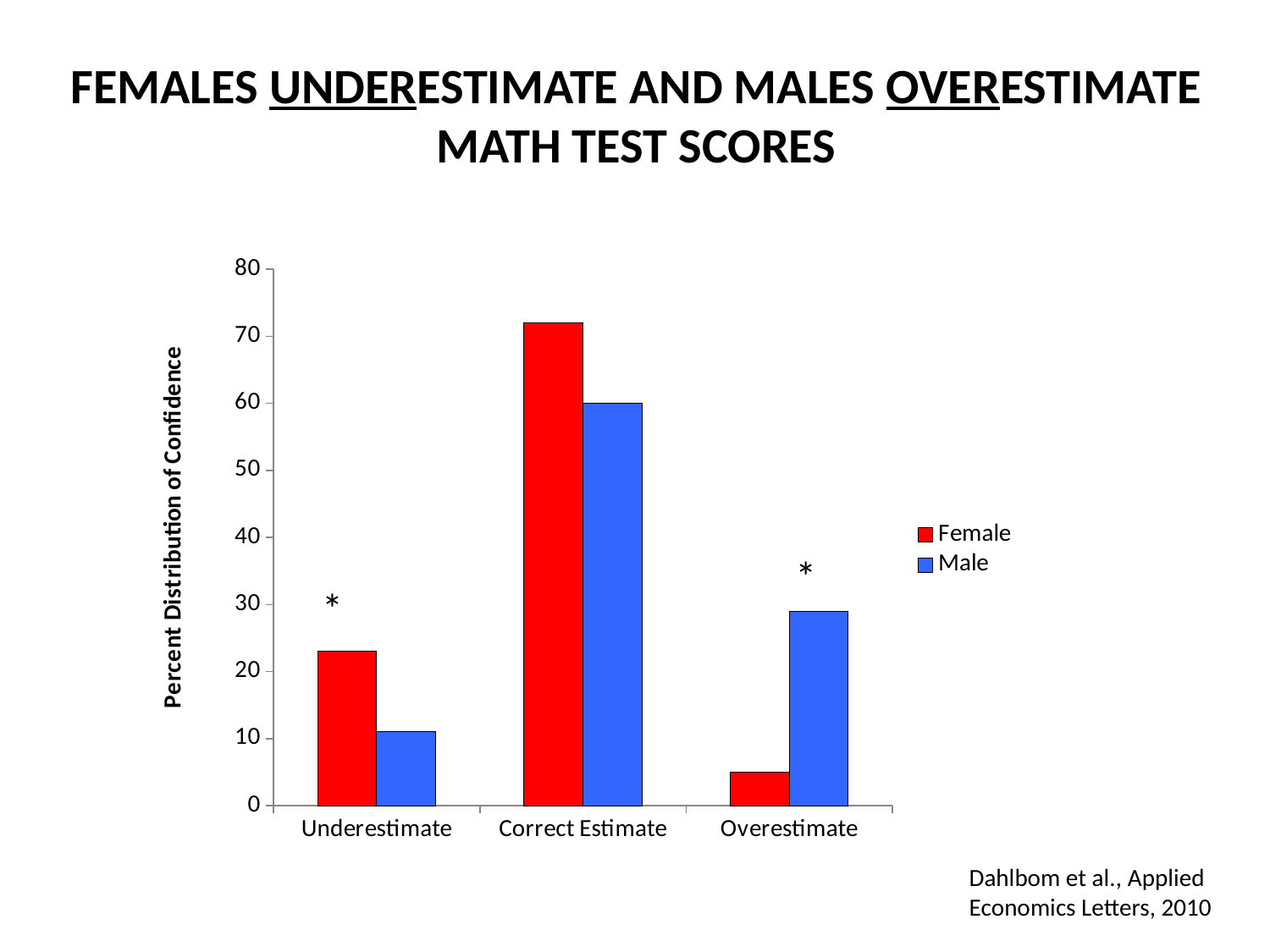
Is the Female value for Underestimate greater or less than 20? greater What is the title of the y axis? Percent Distribution of Confidence In the Overestimate category, which series has the larger value, Female or Male? Male Which bar is the lowest in the chart? Female, Overestimate Is the Female value for Overestimate greater or less than 10? less What kind of chart is shown on the slide? bar chart How many series does the legend list? 2 Which category has the tallest bar in the chart? Correct Estimate (Female) How many categories are shown on the x axis? 3 Is the Male value for Overestimate greater or less than 20? greater In the Correct Estimate category, which series has the larger value, Female or Male? Female In the Underestimate category, which series has the larger value, Female or Male? Female